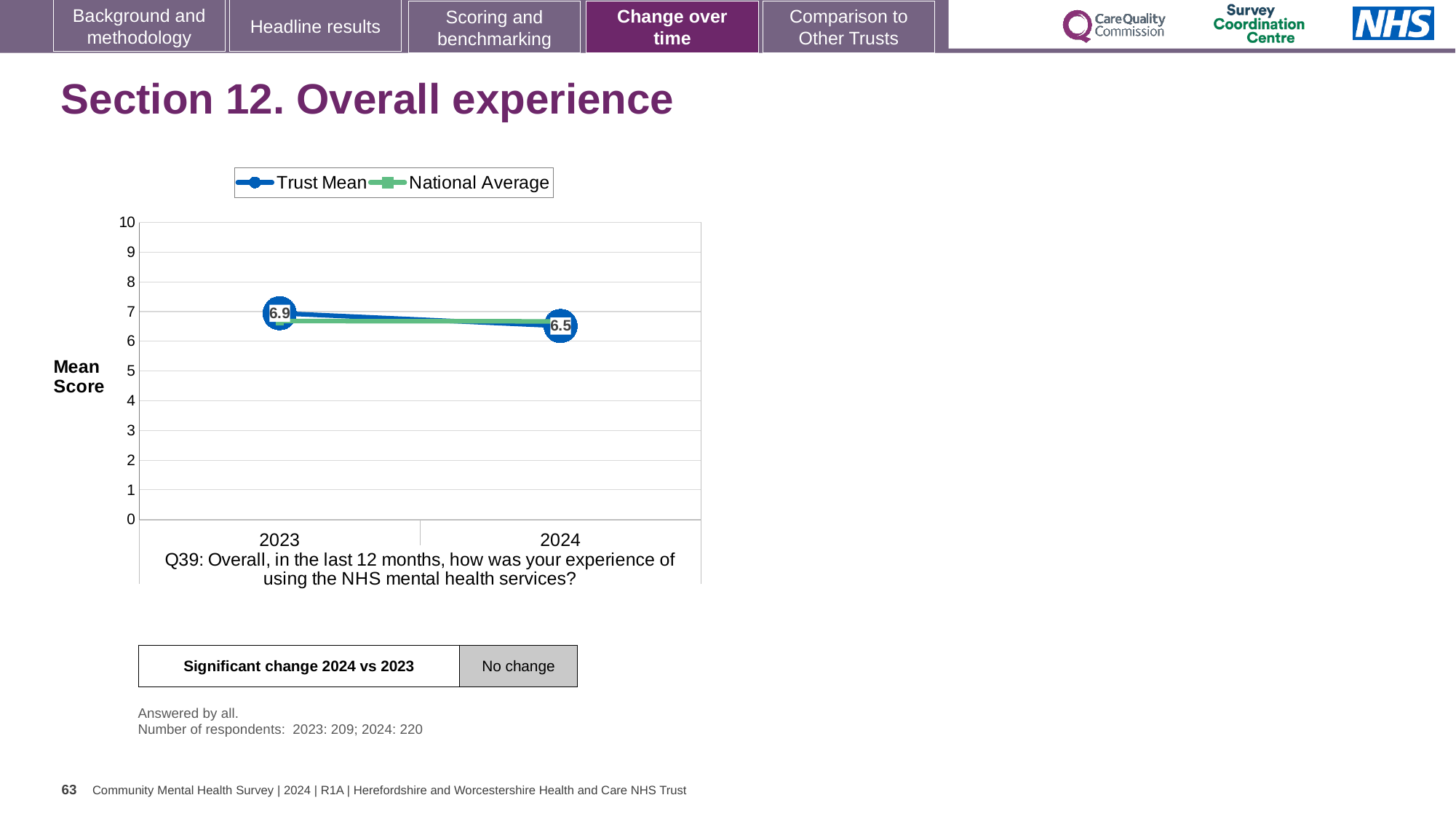
Is the National Average value for 2024 greater or less than 8? less In which year is the Trust Mean lowest? 2024 Which year has the higher Trust Mean, 2023 or 2024? 2023 What is the Trust Mean value for 2024? 6.5 How many series does the legend list? 2 What is the Trust Mean value for 2023? 6.9 What is the difference between the Trust Mean in 2023 and in 2024? 0.4 What are the two series named in the legend? Trust Mean and National Average How many years are plotted on the x axis? 2 Does the Trust Mean rise or fall from 2023 to 2024? fall Is the National Average value for 2023 greater or less than 5? greater What kind of chart is shown on the slide? line chart